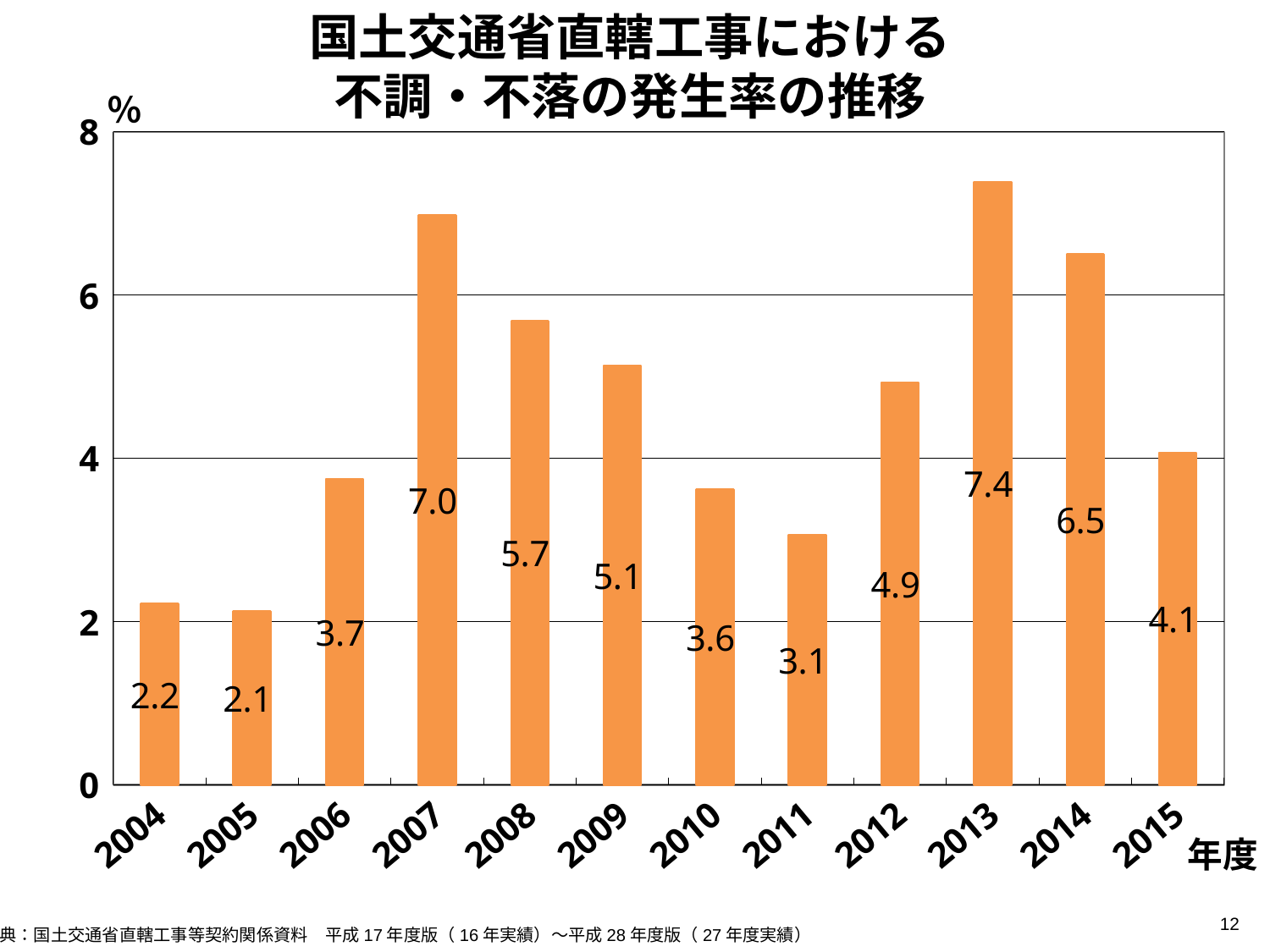
What is the value for 2015? 4.1 What kind of chart is this? bar chart What is the value for 2011? 3.1 Which is larger, the value for 2012 or the value for 2010? 2012 Which year has the lowest value? 2005 What unit is shown at the top of the y axis? % How many years are shown on the x axis? 12 What is the difference between the values for 2008 and 2009? 0.6 Which year has the highest value? 2013 What is the difference between the values for 2013 and 2014? 0.9 Is the value for 2006 greater or less than 4? less What is the value for 2007? 7.0